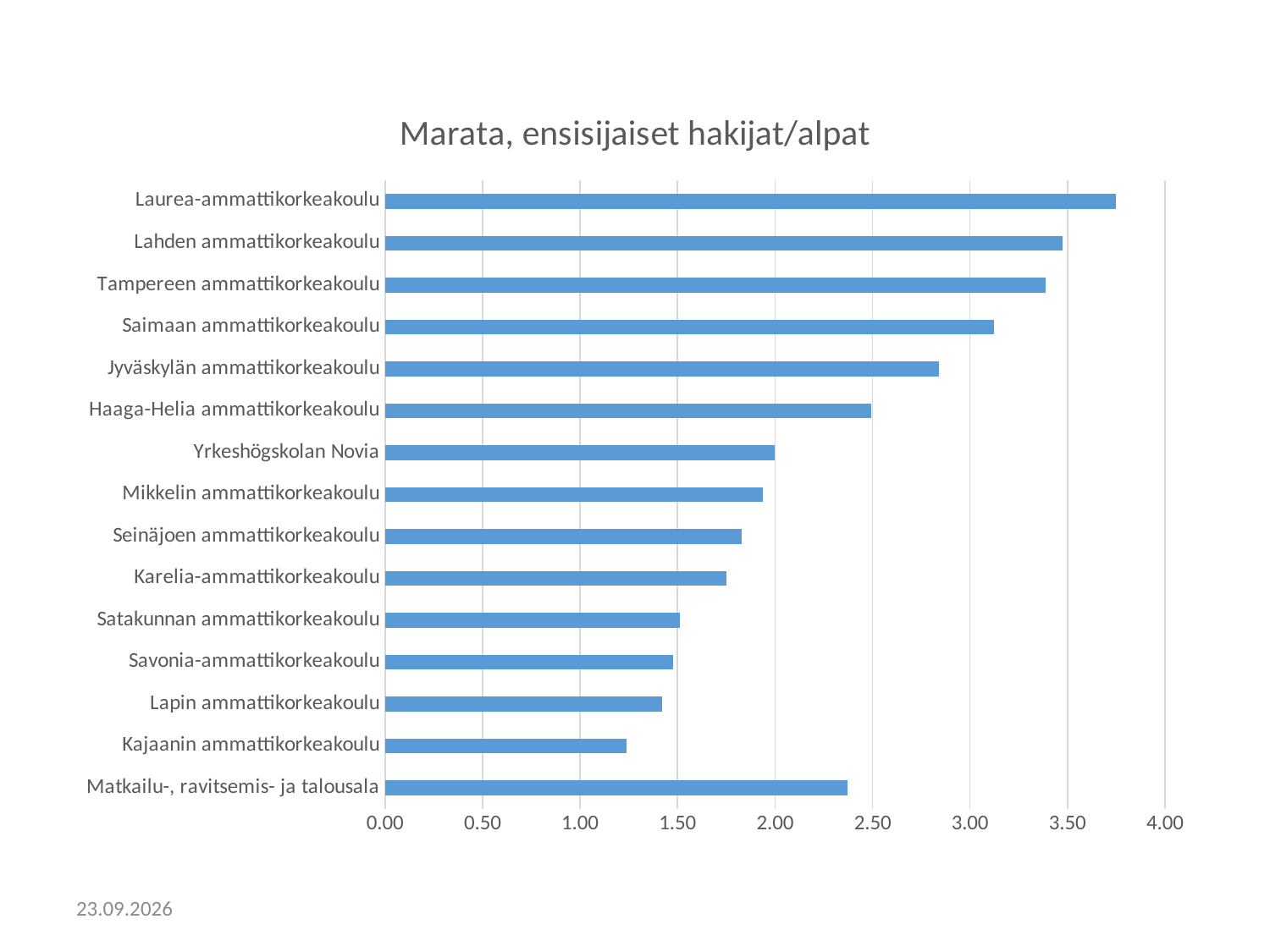
What type of chart is shown on the slide? bar chart How many categories are plotted in the chart? 15 Which category has the lowest value? Kajaanin ammattikorkeakoulu Is the value for Laurea-ammattikorkeakoulu greater or less than 3.50? greater Is the value for Matkailu-, ravitsemis- ja talousala greater or less than 2.00? greater Is the value for Jyväskylän ammattikorkeakoulu greater or less than 3.00? less Which category has the highest value? Laurea-ammattikorkeakoulu What is the title of the chart? Marata, ensisijaiset hakijat/alpat Which has a larger value, Saimaan ammattikorkeakoulu or Jyväskylän ammattikorkeakoulu? Saimaan ammattikorkeakoulu Which has a larger value, Matkailu-, ravitsemis- ja talousala or Kajaanin ammattikorkeakoulu? Matkailu-, ravitsemis- ja talousala